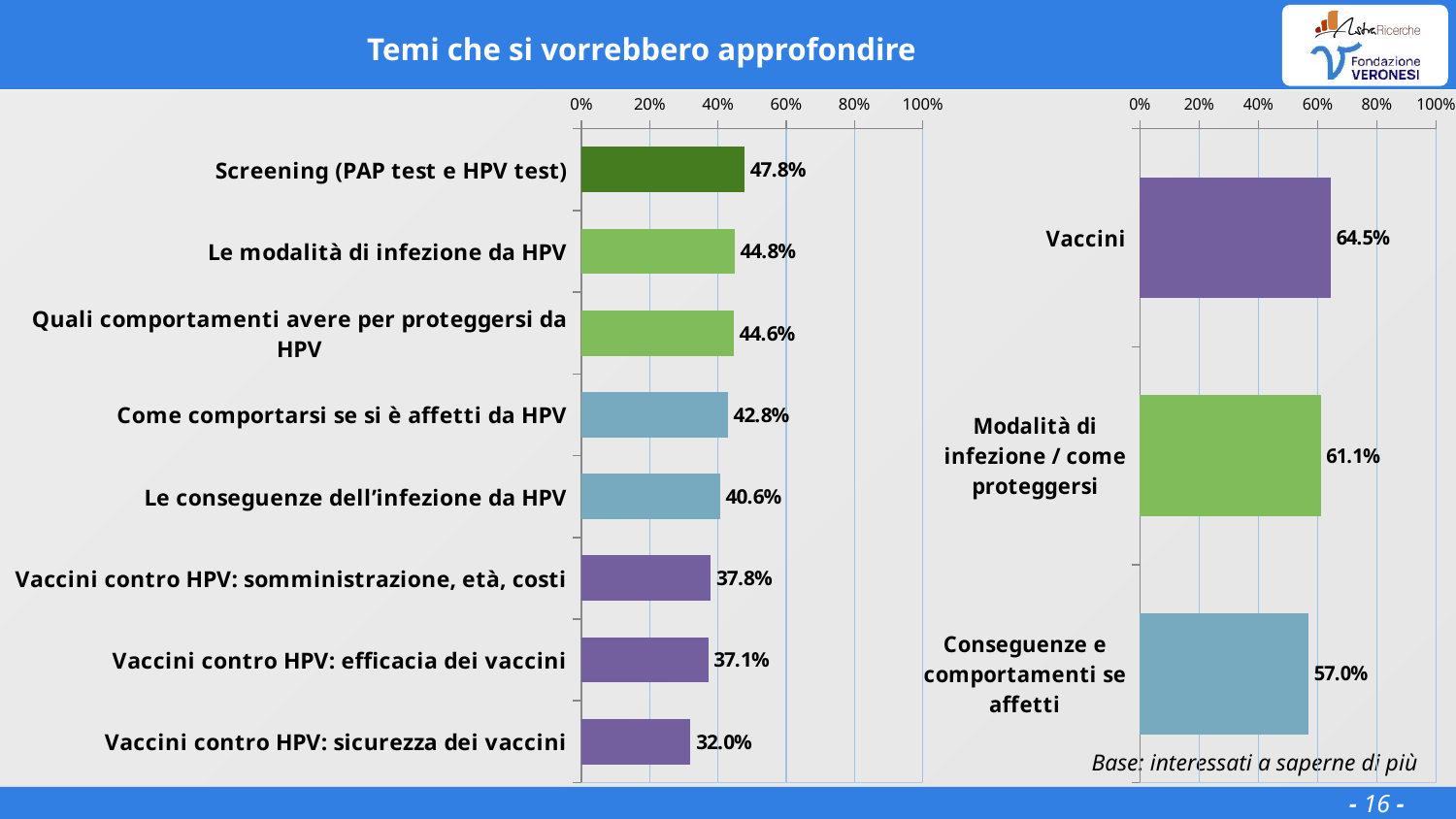
How many categories does the left chart show? 8 In the right chart, what is the value for 'Vaccini'? 64.5% In the right chart, what is the difference between 'Vaccini' and 'Modalità di infezione / come proteggersi'? 3.4% In the left chart, what is the difference between 'Screening (PAP test e HPV test)' and 'Vaccini contro HPV: sicurezza dei vaccini'? 15.8% How many categories does the right chart show? 3 In the left chart, what is the value for 'Vaccini contro HPV: efficacia dei vaccini'? 37.1% In the left chart, which is larger: 'Come comportarsi se si è affetti da HPV' or 'Le conseguenze dell'infezione da HPV'? Come comportarsi se si è affetti da HPV In the left chart, what is the value for 'Screening (PAP test e HPV test)'? 47.8% In the right chart, which category has the lowest value? Conseguenze e comportamenti se affetti In the left chart, which category has the lowest value? Vaccini contro HPV: sicurezza dei vaccini What kind of chart is the right chart? Bar chart In the left chart, which category has the highest value? Screening (PAP test e HPV test)